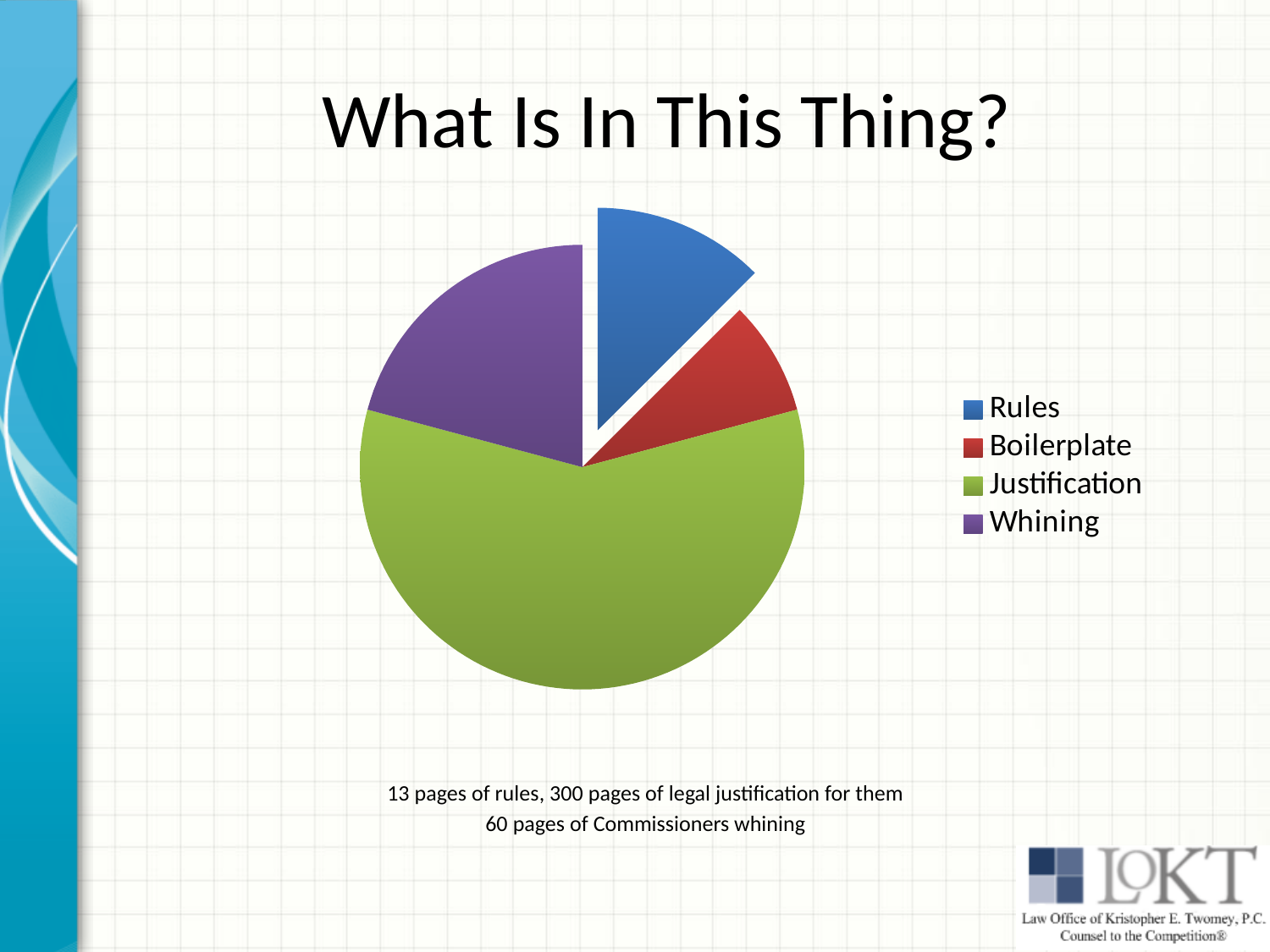
Does the Justification slice take up more or less than half of the pie? more What kind of chart is shown on the slide? pie chart How many slices does the pie chart have? 4 Which category has the smallest slice of the pie chart? Boilerplate Which slice is larger, Rules or Boilerplate? Rules Which slice is larger, Justification or Whining? Justification Which category is shown in green in the pie chart? Justification Which category has the largest slice of the pie chart? Justification How many entries does the legend of the pie chart list? 4 Which slice is larger, Whining or Rules? Whining What is the title of the slide containing the pie chart? What Is In This Thing?